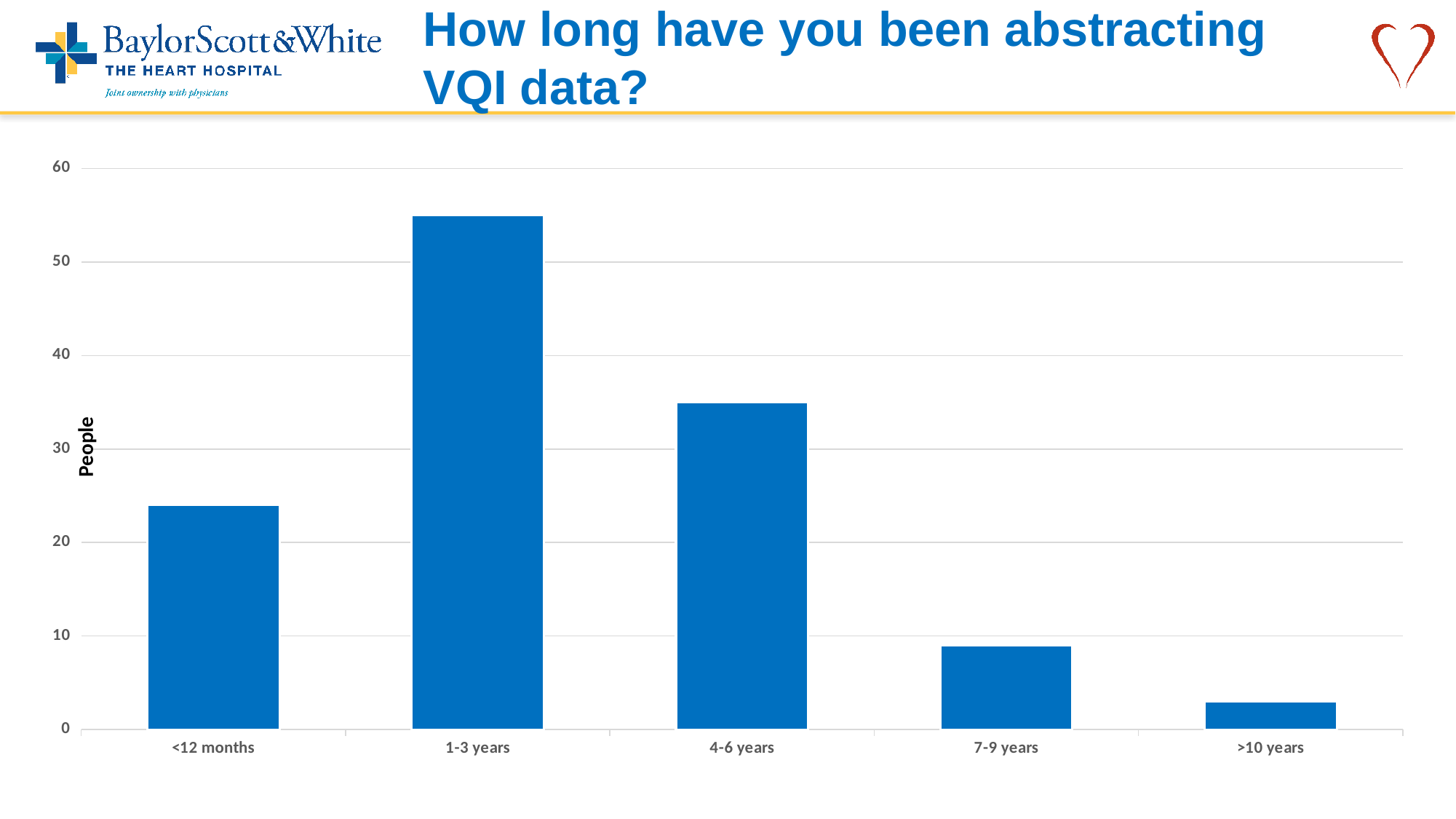
Is the value for 7-9 years greater or less than 10? less Which has more people, 7-9 years or >10 years? 7-9 years Which category has the highest number of people? 1-3 years Which category has the lowest number of people? >10 years Which has more people, <12 months or 4-6 years? 4-6 years Is the value for 1-3 years greater or less than 50? greater Is the value for 4-6 years greater or less than 40? less What is the label on the vertical axis of the chart? People What kind of chart is shown on the slide? bar chart How many categories are shown on the x axis of the chart? 5